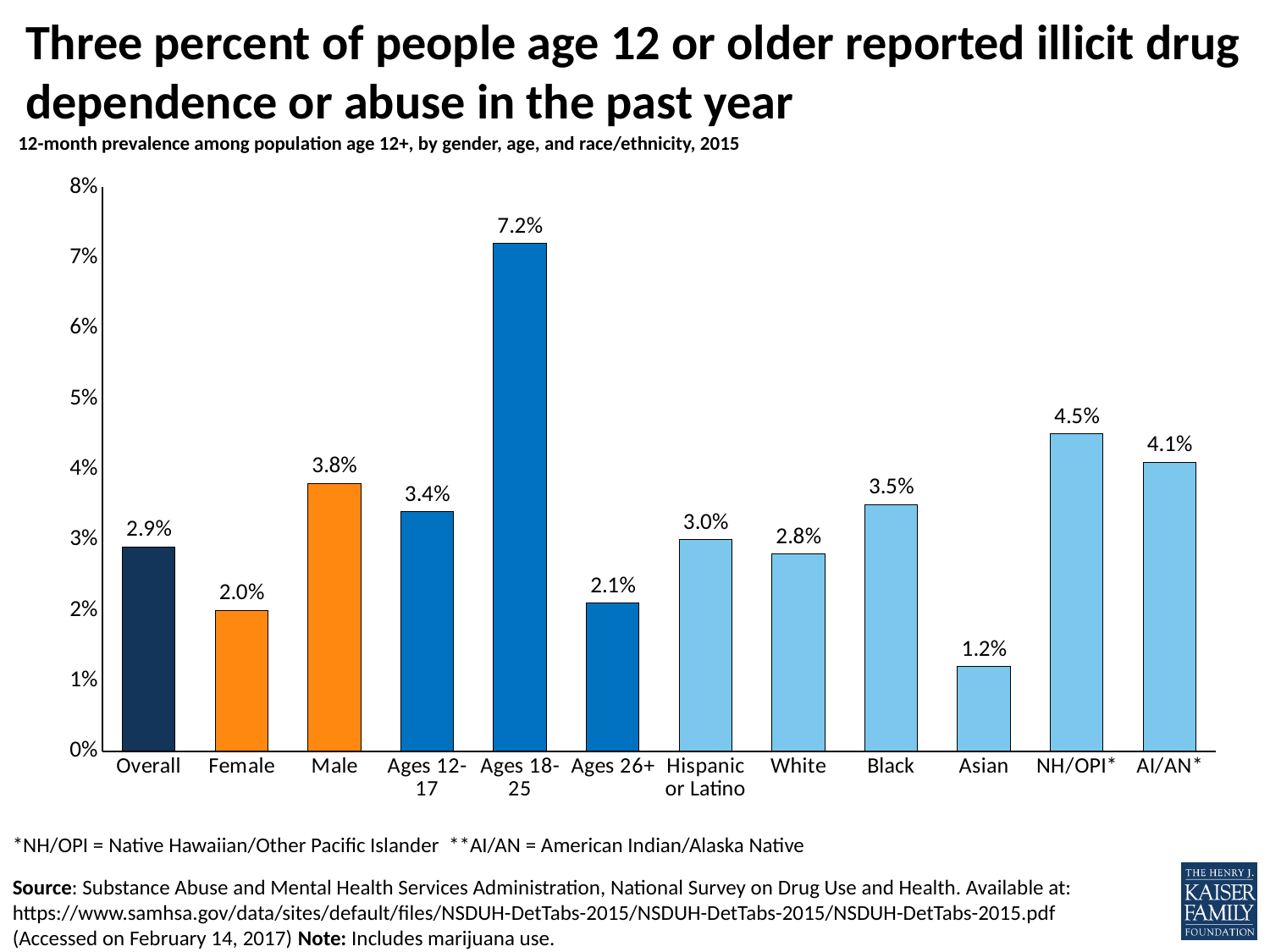
What kind of chart is shown on the slide? bar chart What is the value for Ages 18-25? 7.2% What is the difference between the values for Male and Female? 1.8% Is the value for Black greater or less than 3%? greater What is the value for Overall? 2.9% What is the difference between the values for Ages 18-25 and Ages 26+? 5.1% What is the value for Asian? 1.2% What is the subtitle of the chart? 12-month prevalence among population age 12+, by gender, age, and race/ethnicity, 2015 How many categories are shown on the x axis? 12 Which category has the lowest value? Asian Which category has the highest value? Ages 18-25 Which is larger, the value for NH/OPI* or the value for AI/AN*? NH/OPI*